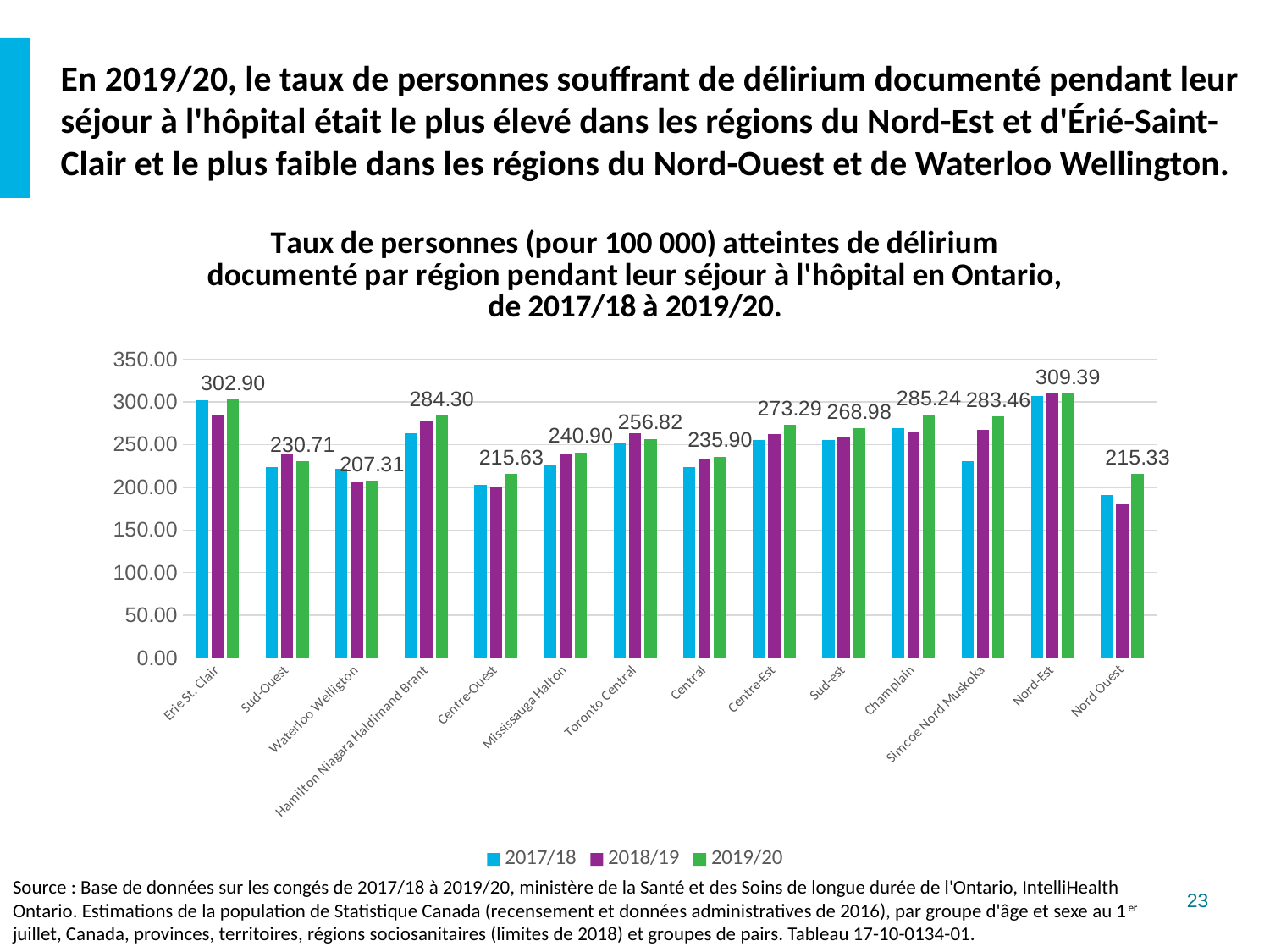
What is the 2019/20 rate for Waterloo Wellington? 207.31 What is the 2019/20 rate for Nord-Est? 309.39 What is the 2019/20 rate for Champlain? 285.24 What type of chart is shown on the slide? bar chart Which region has the lowest 2019/20 rate? Waterloo Wellington Which series is shown in green in the legend? 2019/20 Which region has the highest 2019/20 rate? Nord-Est Is the 2017/18 value for Nord Ouest greater or less than 200.00? less How many regions are shown on the x axis? 14 What is the difference between the 2019/20 rates for Erie St. Clair and Sud-Ouest? 72.19 Which is larger, the 2019/20 rate for Toronto Central or for Central? Toronto Central How many series does the legend list? 3